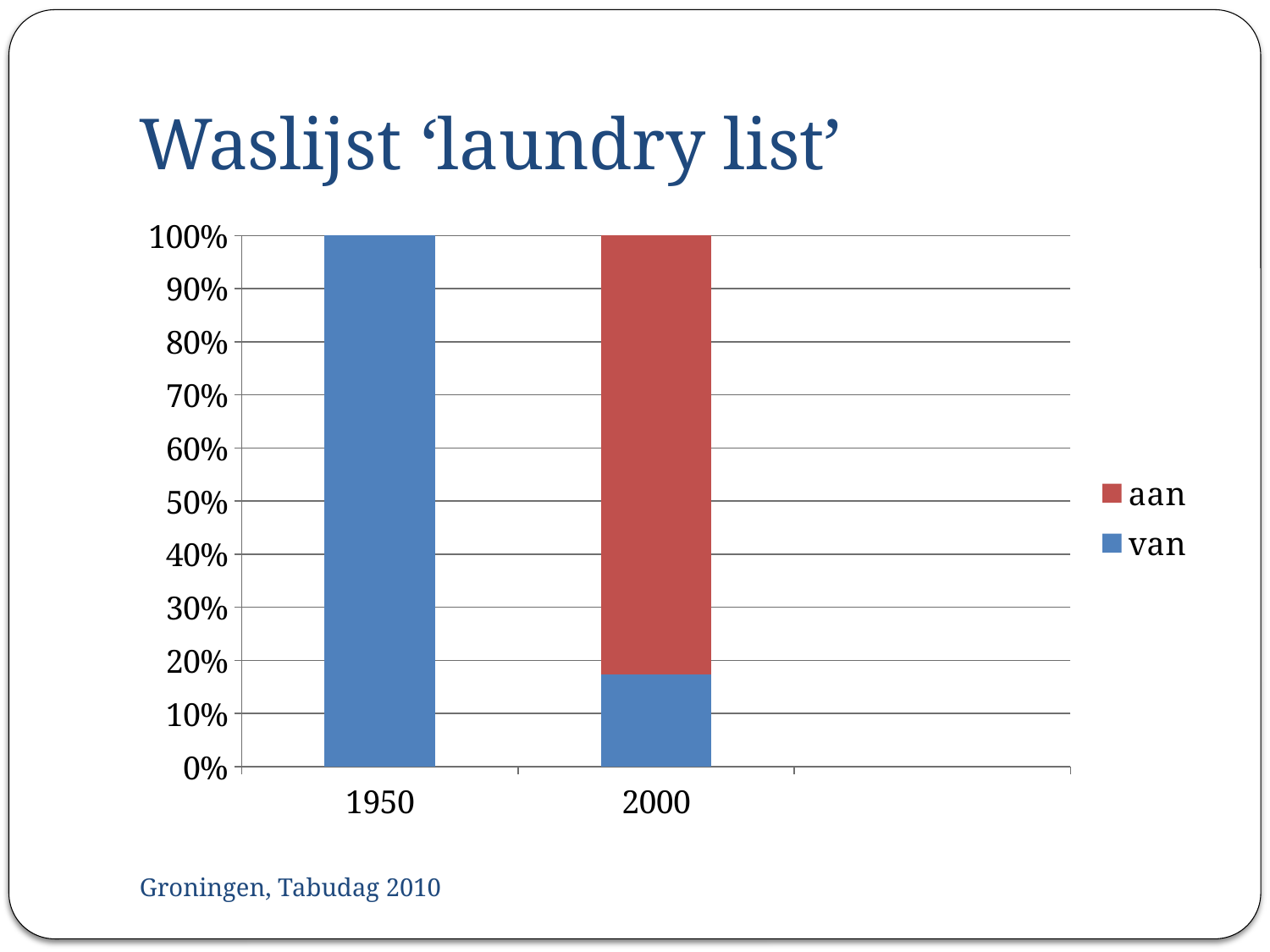
What are the series names listed in the legend? aan, van Is the value for van in 2000 greater or less than 10%? greater What is the value for van in 1950? 100% How many series does the legend list? 2 In 2000, which series has the larger share, aan or van? aan Is the value for aan in 2000 greater or less than 70%? greater What is the total height of the stacked bar for 2000? 100% Is the value for van in 2000 greater or less than 20%? less Does the value for van rise or fall from 1950 to 2000? fall Which year has the higher value for van? 1950 What kind of chart is shown on the slide? bar chart How many categories are shown on the x axis? 2